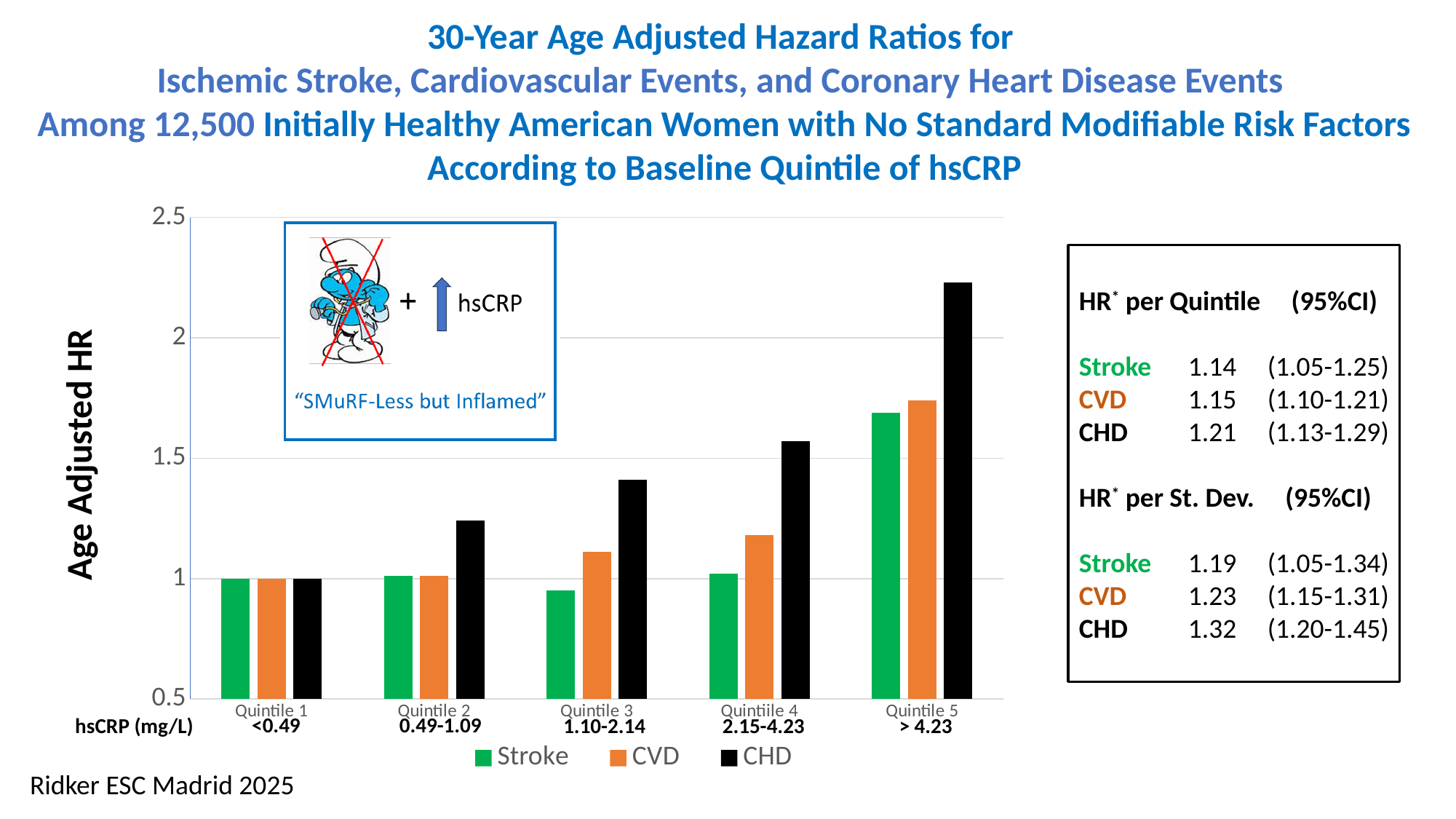
Is the Stroke value for Quintile 5 greater or less than 1.5? greater What kind of chart is shown on the slide? bar chart In Quintile 4, which is larger, the CHD bar or the CVD bar? CHD What is the title of the y axis of the chart? Age Adjusted HR Which series and quintile has the highest age adjusted HR in the chart? CHD, Quintile 5 How many series does the chart legend list? 3 Is the CHD value for Quintile 5 greater or less than 2? greater Is the Stroke value for Quintile 3 greater or less than 1? less Do the CHD values rise or fall from Quintile 1 to Quintile 5? rise How many quintile categories are shown on the x axis? 5 Which series has the lowest bar in Quintile 3? Stroke